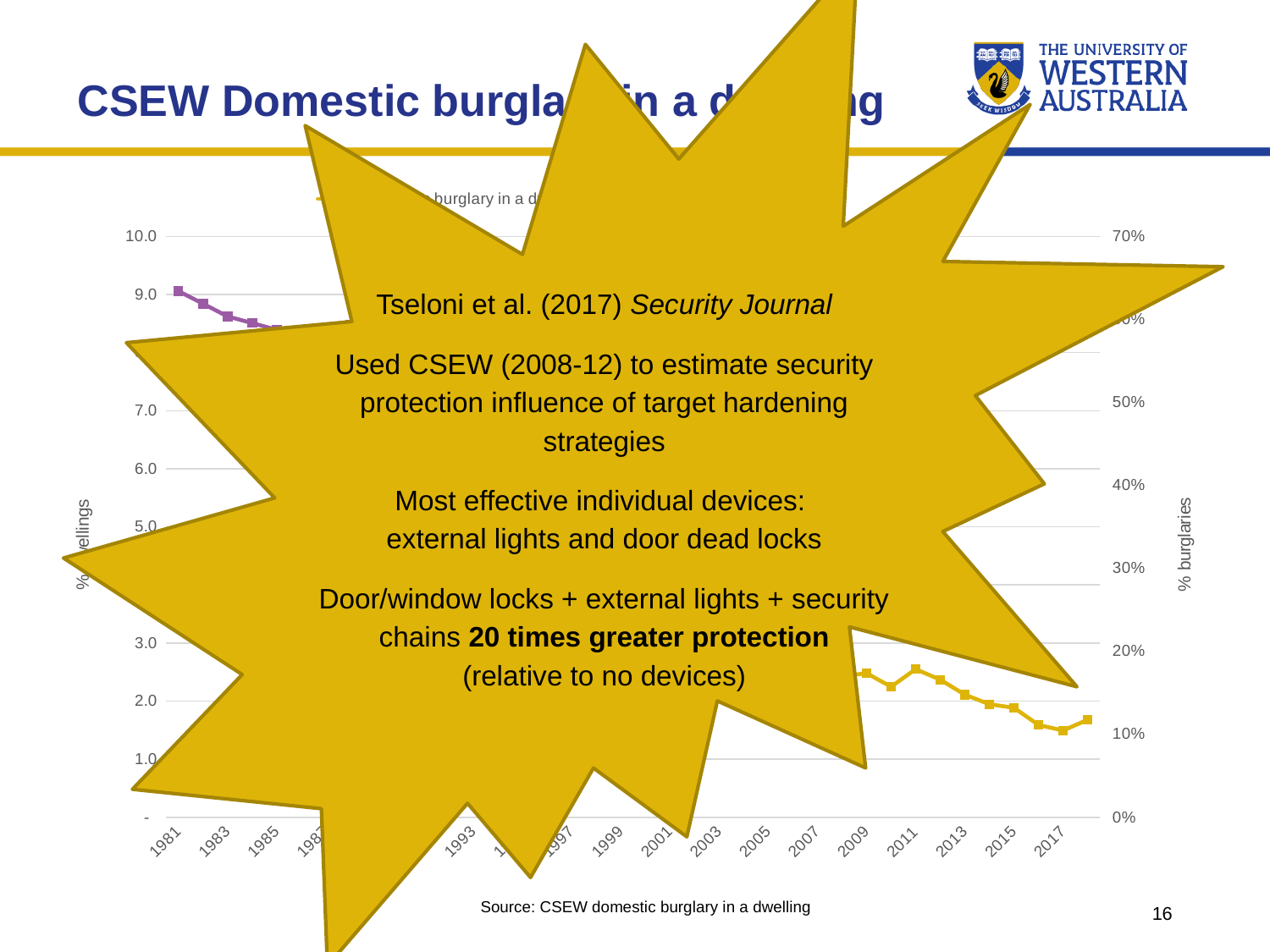
What kind of chart is shown on the slide? line chart Does the yellow line rise or fall between 2011 and 2016? fall What is the label of the right-hand vertical axis? % burglaries Does the purple line rise or fall between 1981 and 1985? fall Is the value of the yellow line in 2009 greater or less than 10% on the right axis? greater Is the value of the yellow line in 2015 greater or less than 20% on the right axis? less Which year has the larger value on the purple line, 1981 or 1985? 1981 What is the highest tick value shown on the right-hand axis? 70% Is the value of the purple line in 1981 greater or less than 8.0 on the left axis? greater Which year has the larger value on the yellow line, 2009 or 2016? 2009